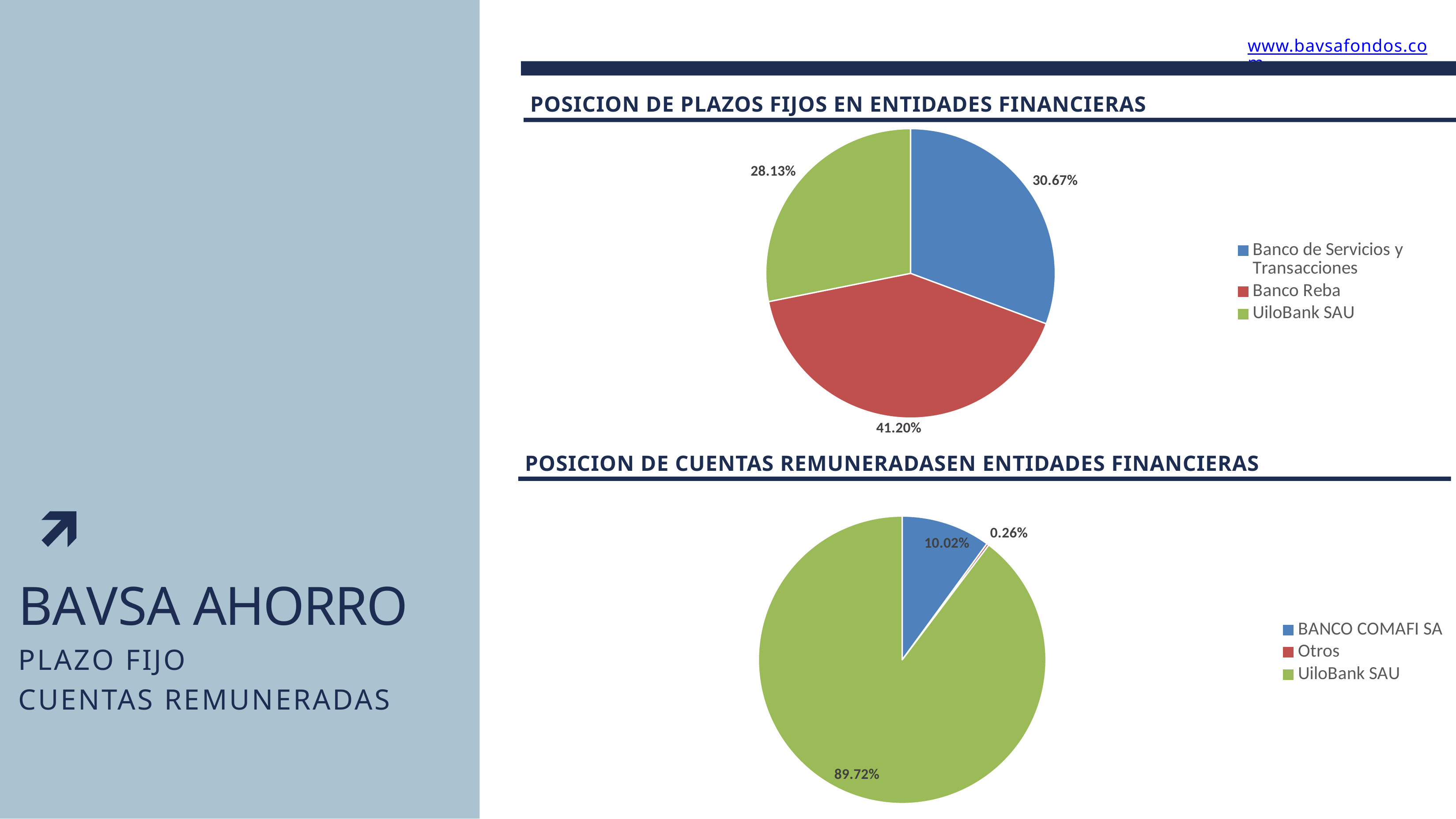
In the 'POSICION DE CUENTAS REMUNERADAS EN ENTIDADES FINANCIERAS' chart, what share does UiloBank SAU hold? 89.72% In the 'POSICION DE PLAZOS FIJOS EN ENTIDADES FINANCIERAS' chart, how many entities are shown in the legend? 3 In the 'POSICION DE PLAZOS FIJOS EN ENTIDADES FINANCIERAS' chart, what share does Banco de Servicios y Transacciones hold? 30.67% What type of chart is the 'POSICION DE PLAZOS FIJOS EN ENTIDADES FINANCIERAS' chart? Pie chart In the 'POSICION DE PLAZOS FIJOS EN ENTIDADES FINANCIERAS' chart, what is the difference between the Banco Reba share and the UiloBank SAU share? 13.07% In the 'POSICION DE CUENTAS REMUNERADAS EN ENTIDADES FINANCIERAS' chart, which is larger: BANCO COMAFI SA or UiloBank SAU? UiloBank SAU In the 'POSICION DE PLAZOS FIJOS EN ENTIDADES FINANCIERAS' chart, which entity has the largest slice? Banco Reba In the 'POSICION DE CUENTAS REMUNERADAS EN ENTIDADES FINANCIERAS' chart, which entity has the smallest slice? Otros In the 'POSICION DE PLAZOS FIJOS EN ENTIDADES FINANCIERAS' chart, which entity has the smallest slice? UiloBank SAU In the 'POSICION DE PLAZOS FIJOS EN ENTIDADES FINANCIERAS' chart, what share does Banco Reba hold? 41.20% In the 'POSICION DE CUENTAS REMUNERADAS EN ENTIDADES FINANCIERAS' chart, what share does Otros hold? 0.26% In the 'POSICION DE CUENTAS REMUNERADAS EN ENTIDADES FINANCIERAS' chart, what share does BANCO COMAFI SA hold? 10.02%